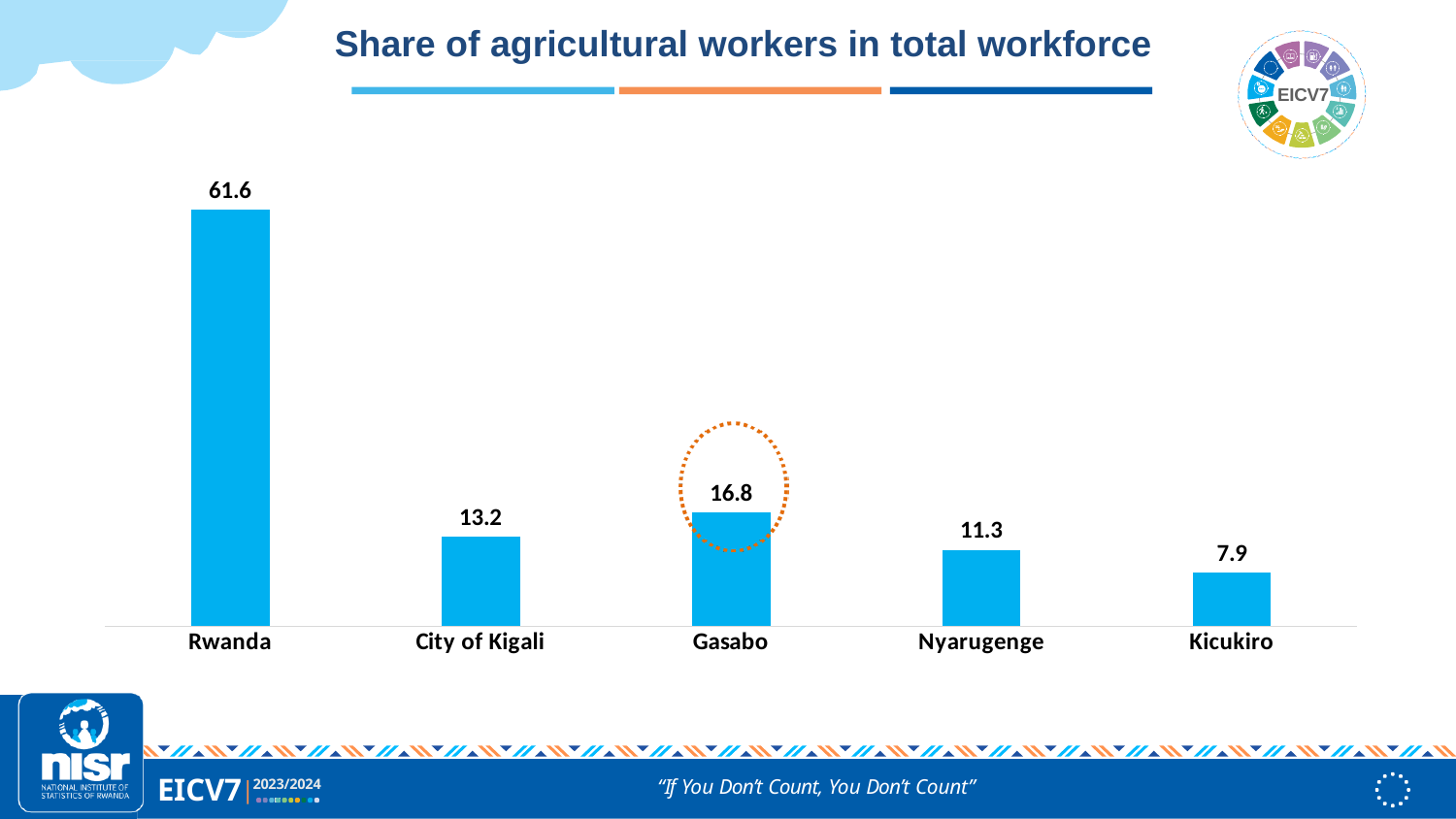
How many categories are shown on the chart? 5 What kind of chart is shown on the slide? Bar chart Which has a larger value, Gasabo or Kicukiro? Gasabo What is the difference between the values for Rwanda and City of Kigali? 48.4 Which category has the lowest share of agricultural workers? Kicukiro What is the value shown for City of Kigali? 13.2 What is the share of agricultural workers in the total workforce for Rwanda? 61.6 What is the value shown for Kicukiro? 7.9 What is the value shown for Gasabo? 16.8 What is the difference between the values for Gasabo and Nyarugenge? 5.5 What is the value shown for Nyarugenge? 11.3 Which category has the highest share of agricultural workers? Rwanda